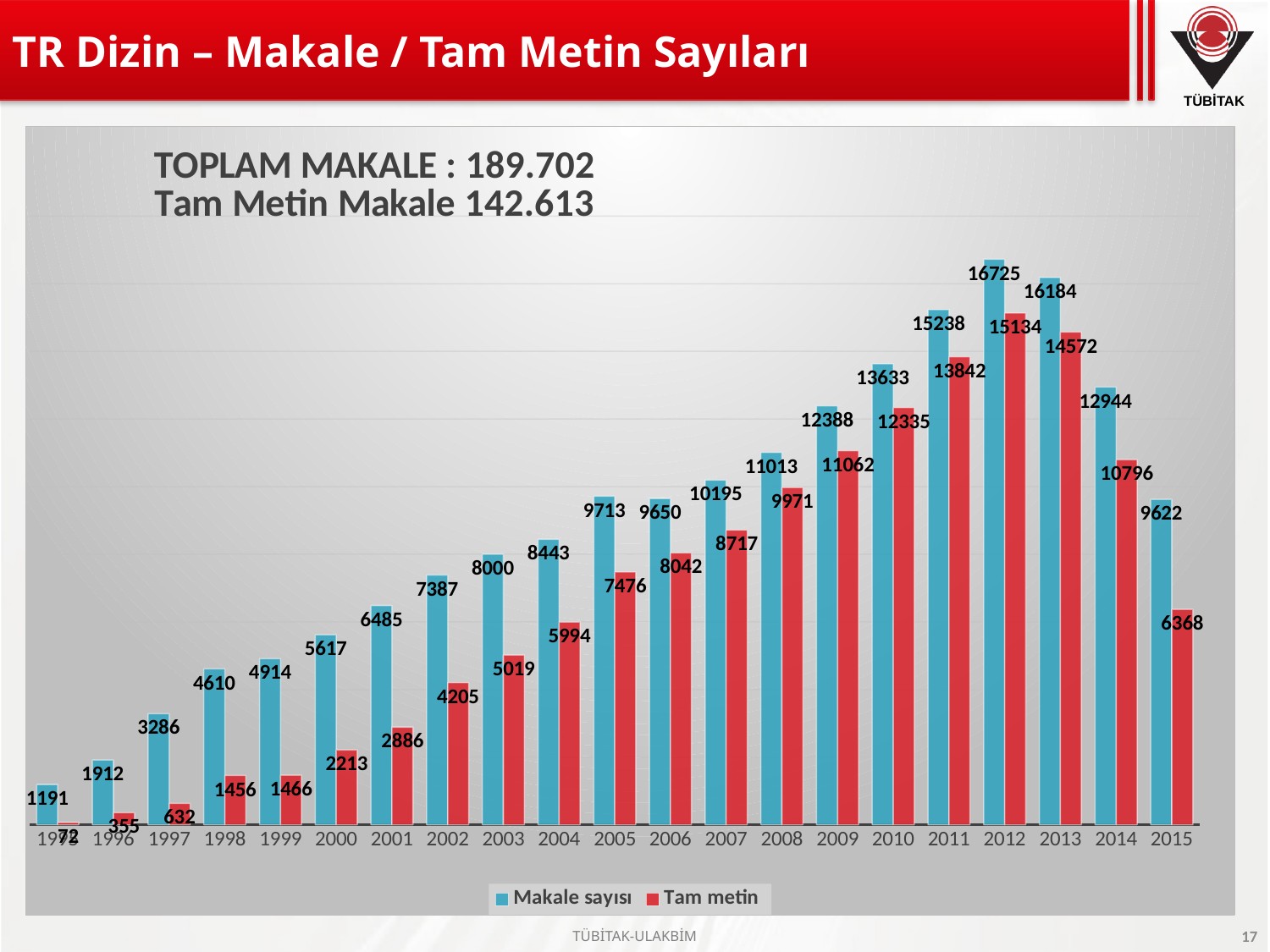
Which is larger, the Tam metin value for 2013 or the Tam metin value for 2014? 2013 What is the Makale sayısı value for 2000? 5617 How many series does the legend list? 2 What is the Tam metin value for 2005? 7476 What type of chart is shown on the slide? bar chart What total number of articles (TOPLAM MAKALE) is stated on the slide? 189.702 What is the difference between the Makale sayısı values for 2012 and 2013? 541 What is the difference between Makale sayısı and Tam metin in 2015? 3254 How does the Makale sayısı value change from 2012 to 2015? It falls Which year has the lowest Tam metin value? 1995 What is the Makale sayısı value for 2012? 16725 Which year has the highest Makale sayısı value? 2012